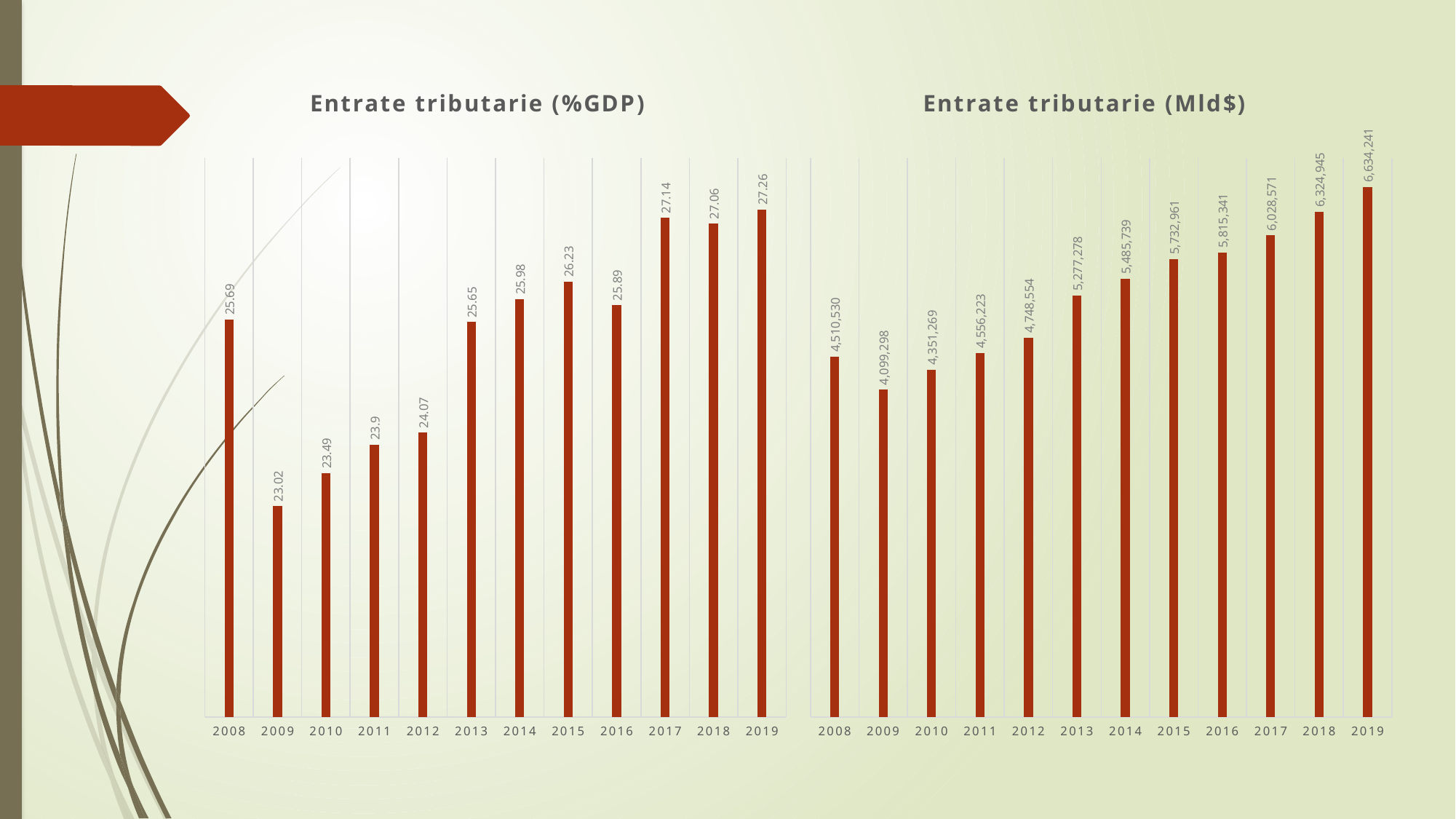
In the 'Entrate tributarie (Mld$)' chart, what is the value for 2015? 5,732,961 In the 'Entrate tributarie (%GDP)' chart, which year has the lowest value? 2009 In the 'Entrate tributarie (%GDP)' chart, which is larger, the value for 2015 or the value for 2016? 2015 In the 'Entrate tributarie (Mld$)' chart, which year has the highest value? 2019 In the 'Entrate tributarie (Mld$)' chart, which year has the lowest value? 2009 In the 'Entrate tributarie (%GDP)' chart, which year has the highest value? 2019 In the 'Entrate tributarie (%GDP)' chart, what is the value for 2012? 24.07 In the 'Entrate tributarie (%GDP)' chart, what is the difference between the 2019 value and the 2008 value? 1.57 In the 'Entrate tributarie (Mld$)' chart, do the values generally rise or fall from 2009 to 2019? Rise What kind of chart is the 'Entrate tributarie (%GDP)' chart? Bar chart In the 'Entrate tributarie (Mld$)' chart, what is the difference between the 2019 value and the 2018 value? 309,296 How many years are shown on the x axis of the 'Entrate tributarie (Mld$)' chart? 12